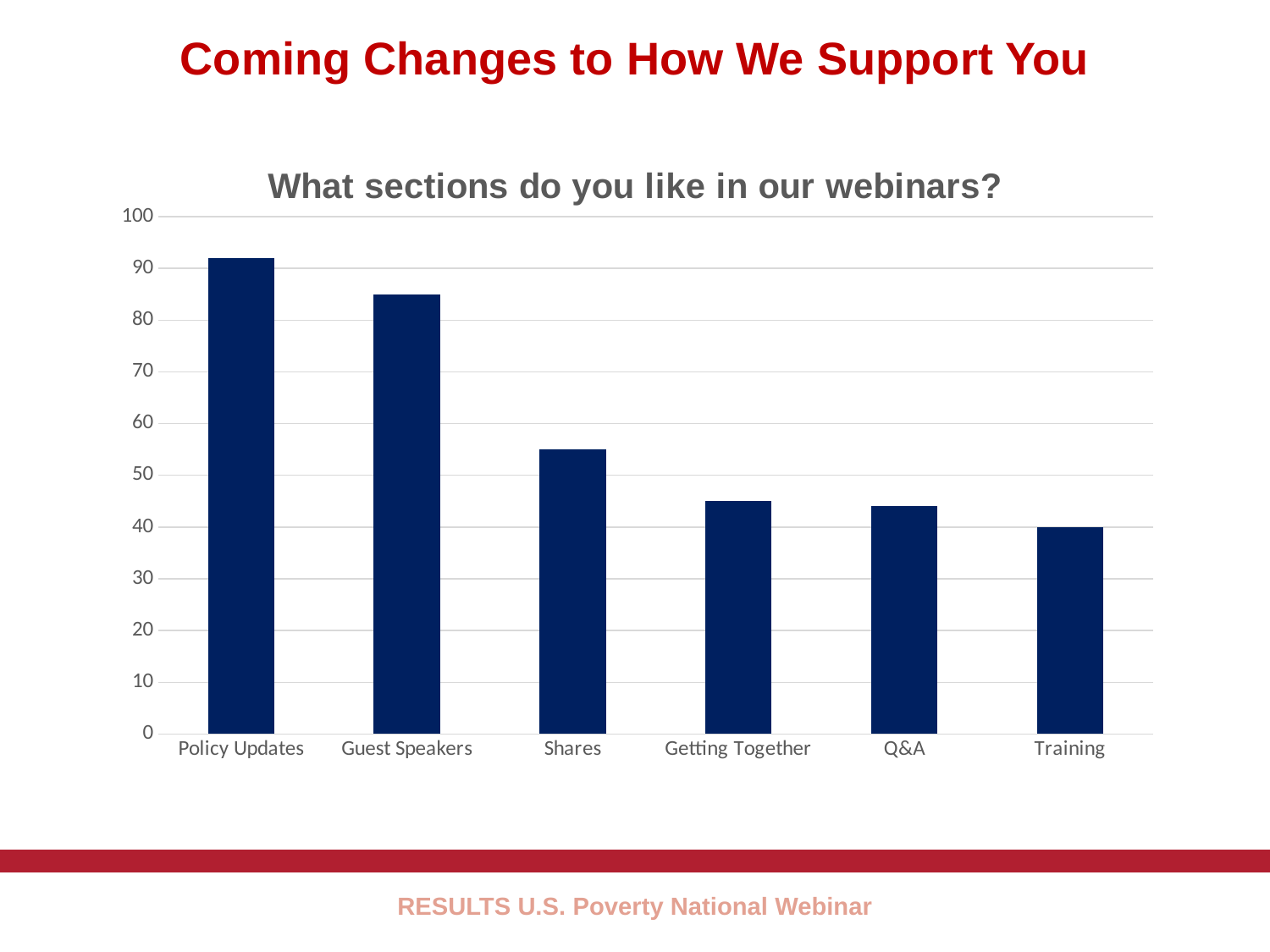
Which is larger, the value for Shares or the value for Training? Shares Is the value for Policy Updates greater or less than 90? greater Which is larger, the value for Guest Speakers or the value for Shares? Guest Speakers Which category has the lowest value? Training Do the values generally rise or fall from left to right across the categories? fall Is the value for Guest Speakers greater or less than 80? greater Is the value for Shares greater or less than 60? less Which category has the highest value? Policy Updates How many categories are shown on the x axis of the chart? 6 What is the title of the chart? What sections do you like in our webinars? What type of chart is shown on the slide? bar chart